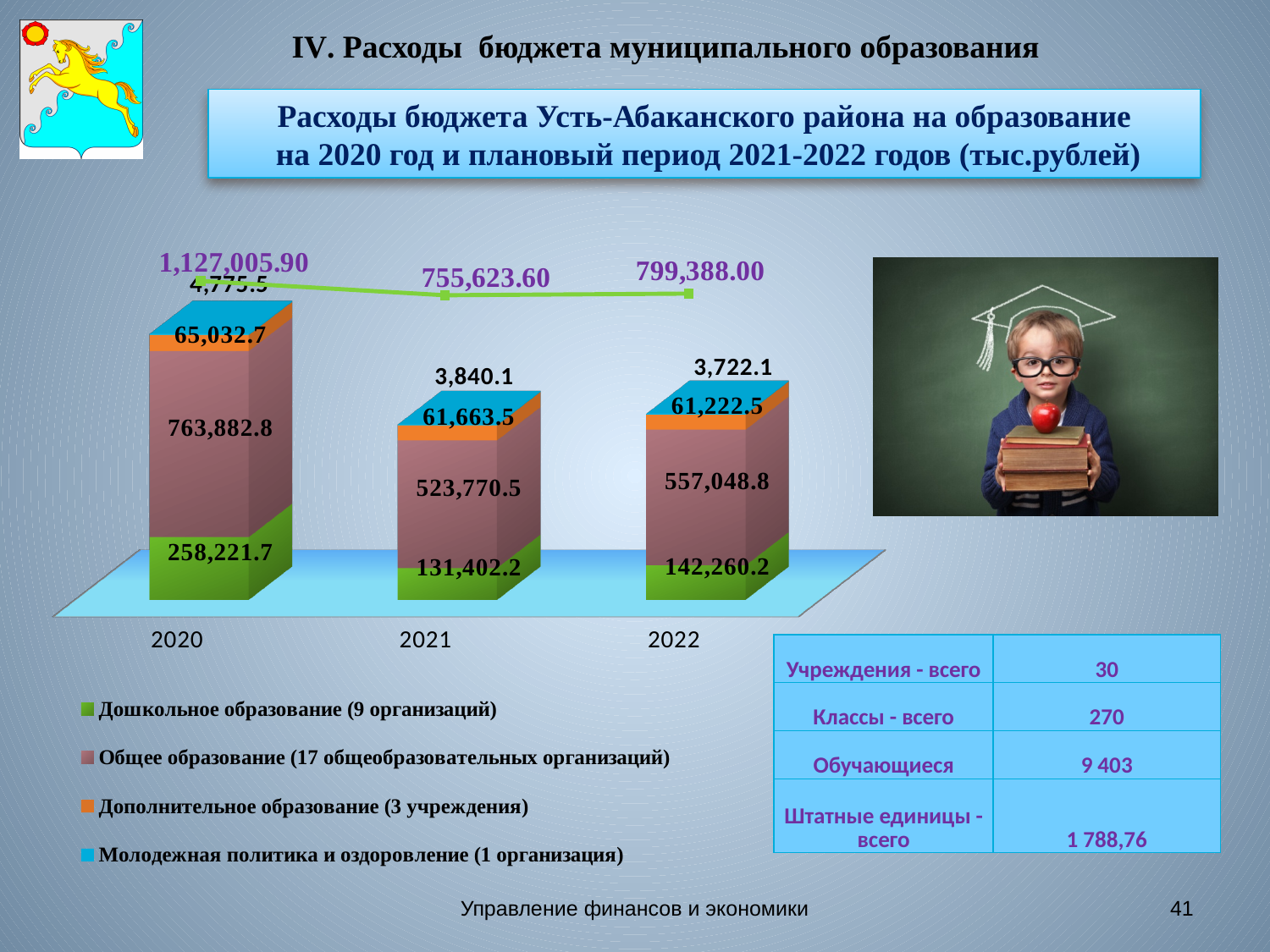
How many years are shown on the x axis of the chart? 3 Which is larger: Дополнительное образование in 2021 or in 2022? 2021 What kind of chart is shown on the slide? Stacked bar chart with a line What is the value for Молодежная политика и оздоровление in 2021? 3,840.1 What is the difference between the Дошкольное образование values for 2022 and 2021? 10,858.0 How many series does the chart legend list? 4 In which year is the value for Общее образование the highest? 2020 In which year is the value for Дошкольное образование the lowest? 2021 What is the value for Дополнительное образование in 2022? 61,222.5 What is the value for Общее образование in 2020? 763,882.8 What is the value shown on the line series for 2022? 799,388.00 What is the value for Дошкольное образование in 2021? 131,402.2